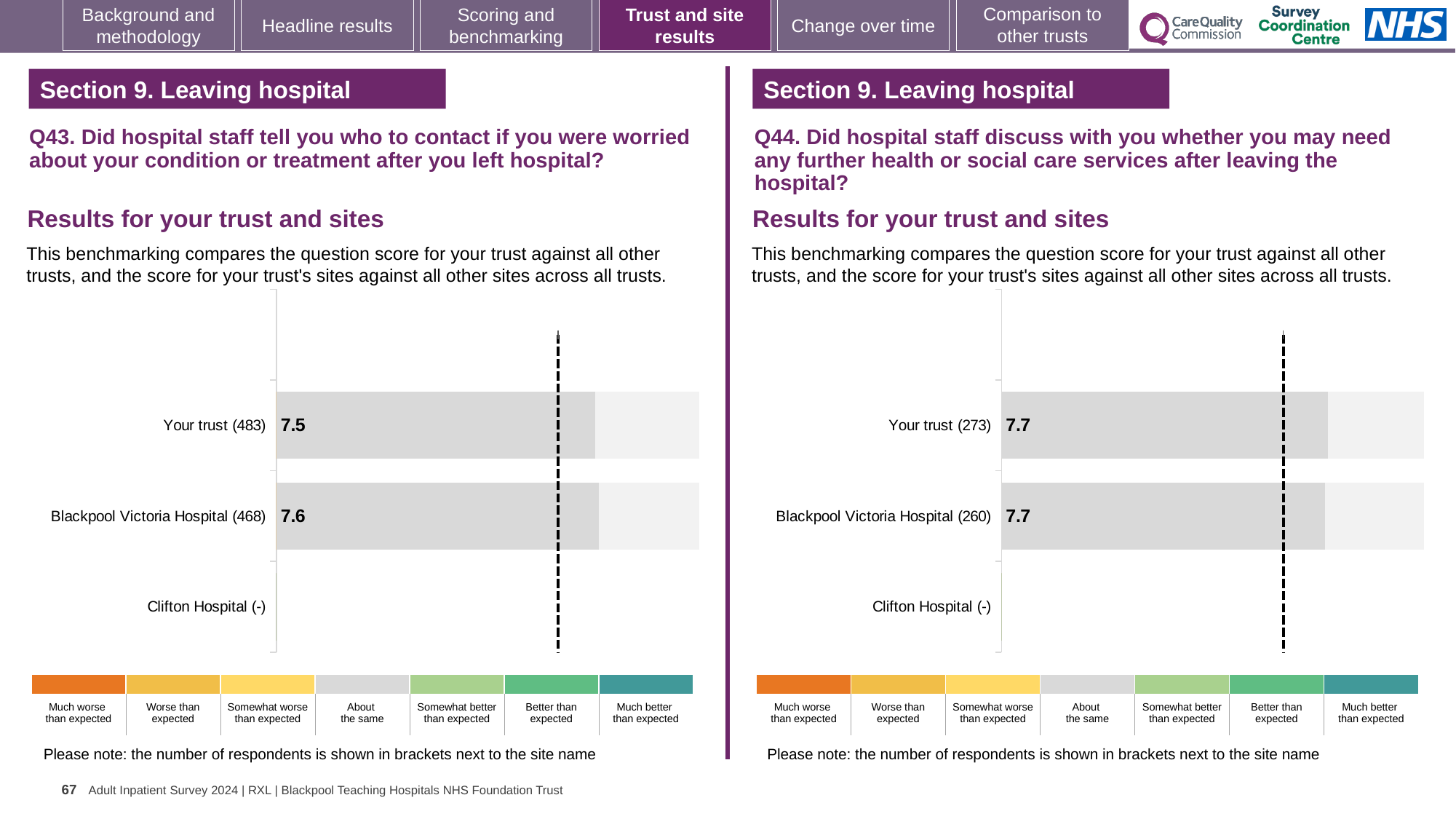
In the Q44 chart on the right, what is the difference between the Your trust score and the Blackpool Victoria Hospital score? 0 In the Q43 chart on the left, what is the difference between the Blackpool Victoria Hospital score and the Your trust score? 0.1 In the Q43 chart on the left, which category has the lowest printed score? Your trust What kind of chart is used for the Q44 results on the right? Bar chart In the Q44 chart on the right, what is the score for Your trust? 7.7 In the Q43 chart on the left, what is the score for Your trust? 7.5 How many categories (rows) are listed in the Q43 chart on the left? 3 In the Q43 chart on the left, how many respondents are shown for Your trust? 483 In the Q43 chart on the left, which has the higher score, Your trust or Blackpool Victoria Hospital? Blackpool Victoria Hospital In the Q44 chart on the right, what is the score for Blackpool Victoria Hospital? 7.7 In the Q44 chart on the right, how many respondents are shown for Blackpool Victoria Hospital? 260 In the Q43 chart on the left, what is the score for Blackpool Victoria Hospital? 7.6